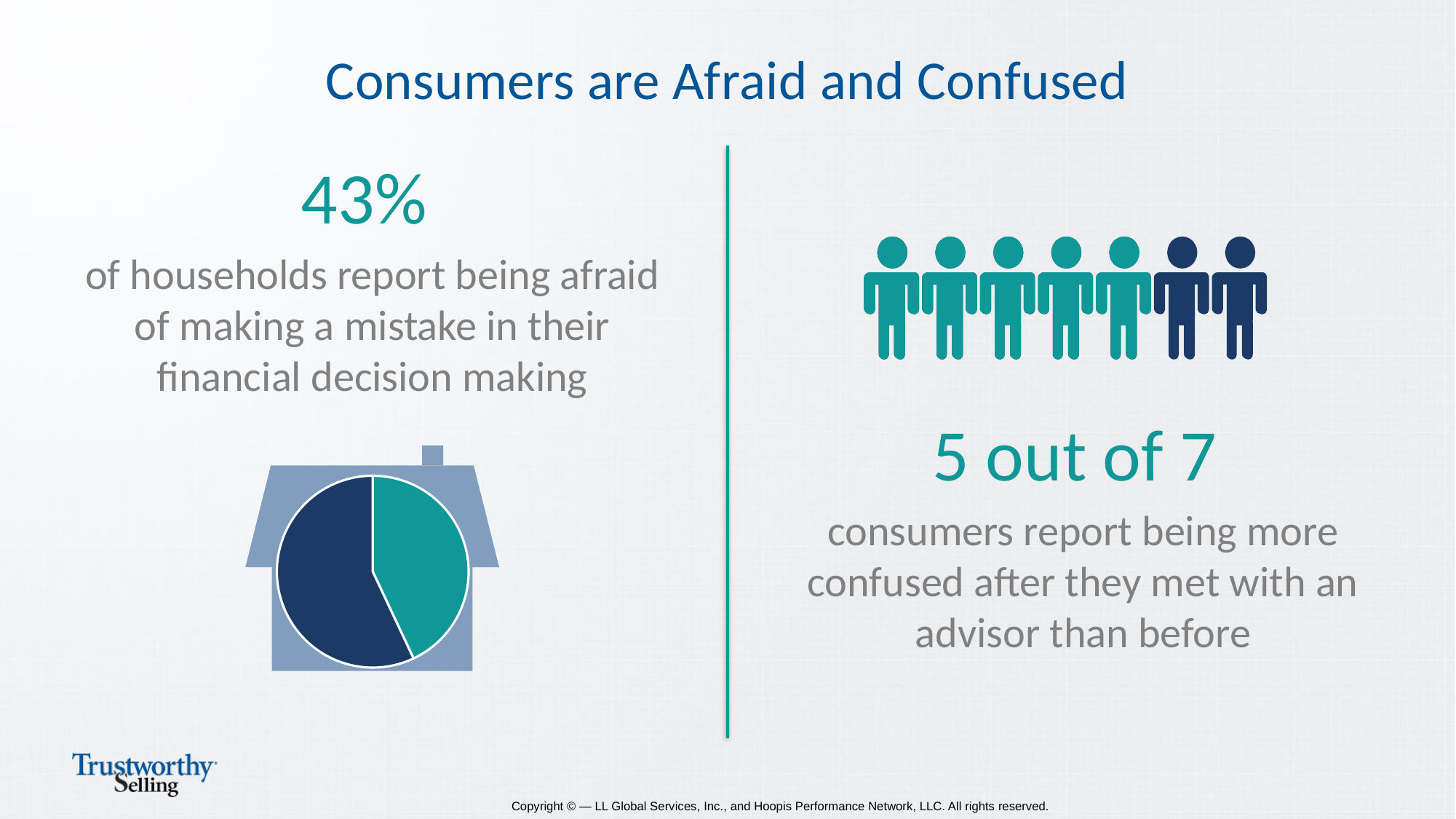
What kind of chart is shown inside the house icon on the left side of the slide? pie chart In the pie chart on the left, what colour is the slice representing the 43% of households who are afraid of making a mistake? teal In the pictograph on the right, how many of the person icons are coloured dark navy? 2 According to the pictograph on the right, how many out of 7 consumers report being more confused after meeting with an advisor than before? 5 out of 7 In the pie chart on the left, is the teal slice greater or less than 50% of the pie? less How many slices does the pie chart on the left have? 2 In the pictograph on the right, how many of the person icons are coloured teal? 5 What is the title of the slide containing the pie chart and the pictograph? Consumers are Afraid and Confused In the pie chart on the left, which slice is larger, the teal slice or the dark navy slice? dark navy In the pictograph on the right, are there more teal icons or more dark navy icons? teal How many person icons are shown in the pictograph on the right side of the slide? 7 In the pie chart on the left, what share of households report being afraid of making a mistake in their financial decision making? 43%